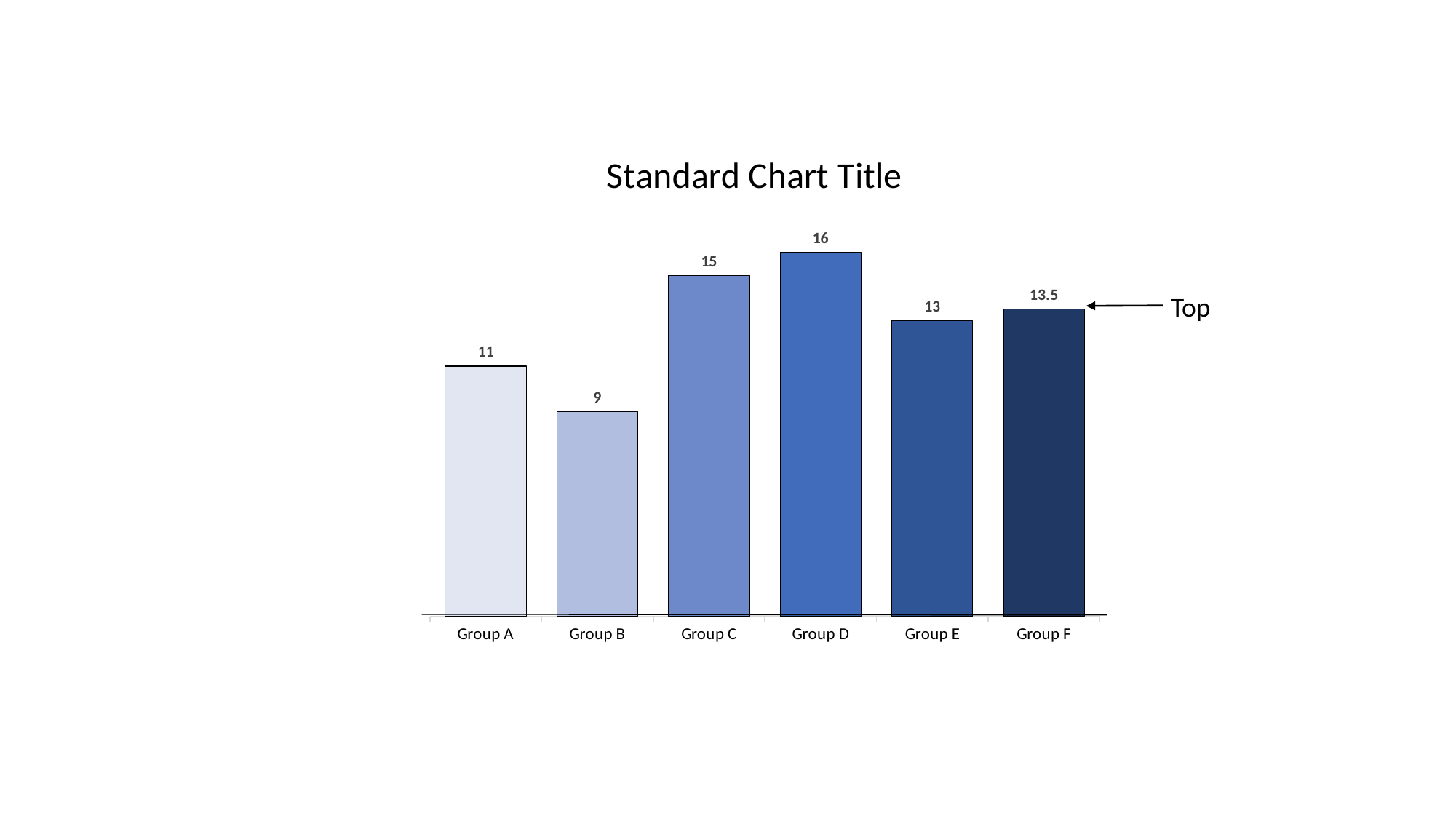
What is the value for Group F? 13.5 Which group has the highest value? Group D Which is larger, the value for Group C or the value for Group E? Group C How many groups are shown on the chart? 6 Which group has the lowest value? Group B What is the value for Group C? 15 What is the title of the chart? Standard Chart Title What is the difference between the values for Group F and Group E? 0.5 Which bar does the arrow labelled "Top" point to? Group F What is the value for Group A? 11 What kind of chart is shown on the slide? Bar chart What is the difference between the values for Group D and Group B? 7